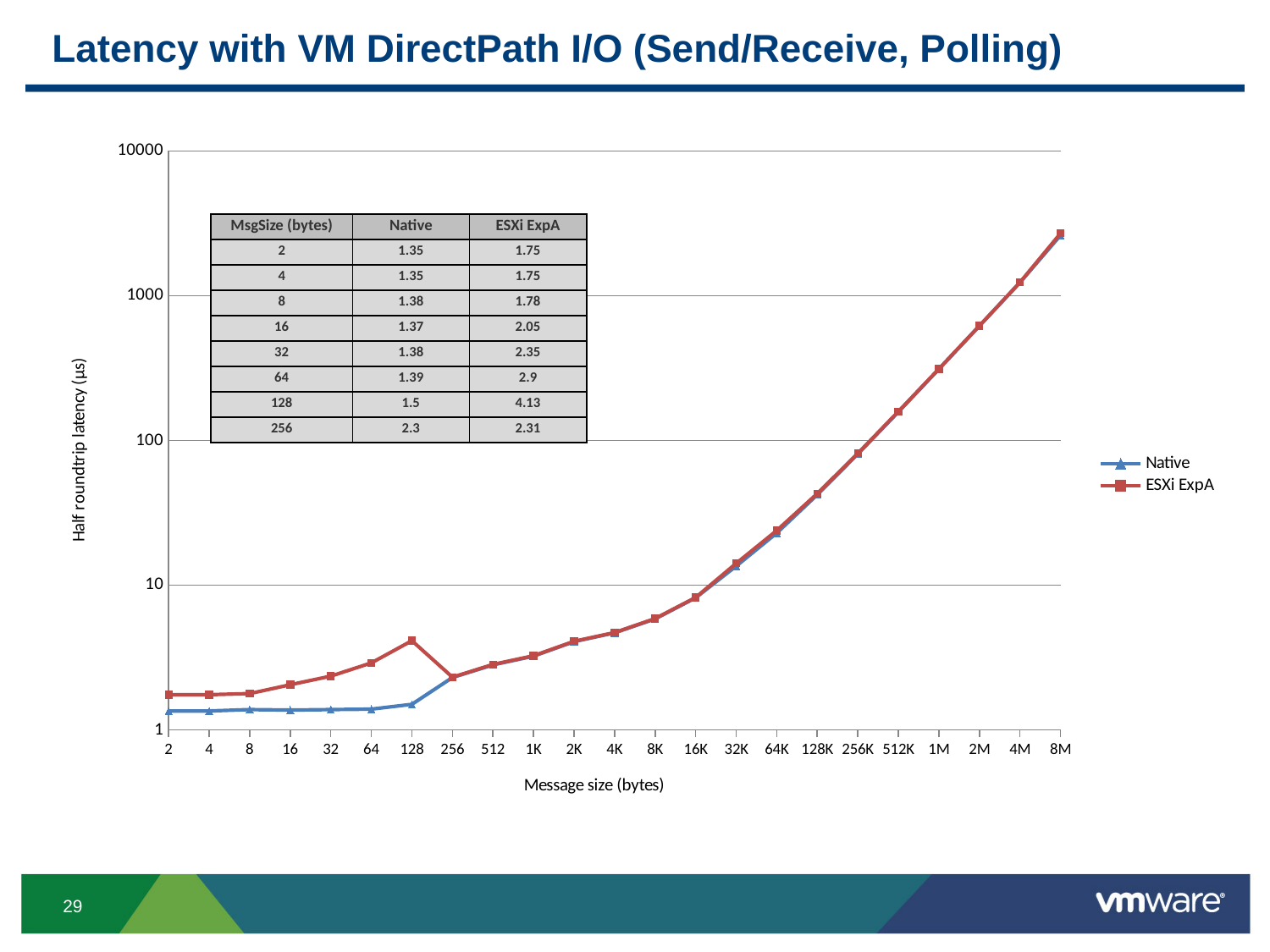
How many message sizes are plotted along the x axis? 23 According to the inset table, what is the Native latency for a message size of 128 bytes? 1.5 According to the inset table, what is the ESXi ExpA latency for a message size of 64 bytes? 2.9 Among the message sizes listed in the inset table, which has the highest ESXi ExpA latency? 128 What is the label of the y axis? Half roundtrip latency (µs) What is the difference between the ESXi ExpA and Native latencies at a message size of 128 bytes, using the inset table? 2.63 Do the latency values generally rise or fall as message size increases from 256 bytes to 8M? rise According to the inset table, what is the ESXi ExpA latency for a message size of 2 bytes? 1.75 At a message size of 32 bytes, which series has the higher latency, Native or ESXi ExpA? ESXi ExpA What kind of chart is shown on the slide? line chart How many series does the legend list? 2 Is the latency for ESXi ExpA at a message size of 8M greater or less than 1000? greater